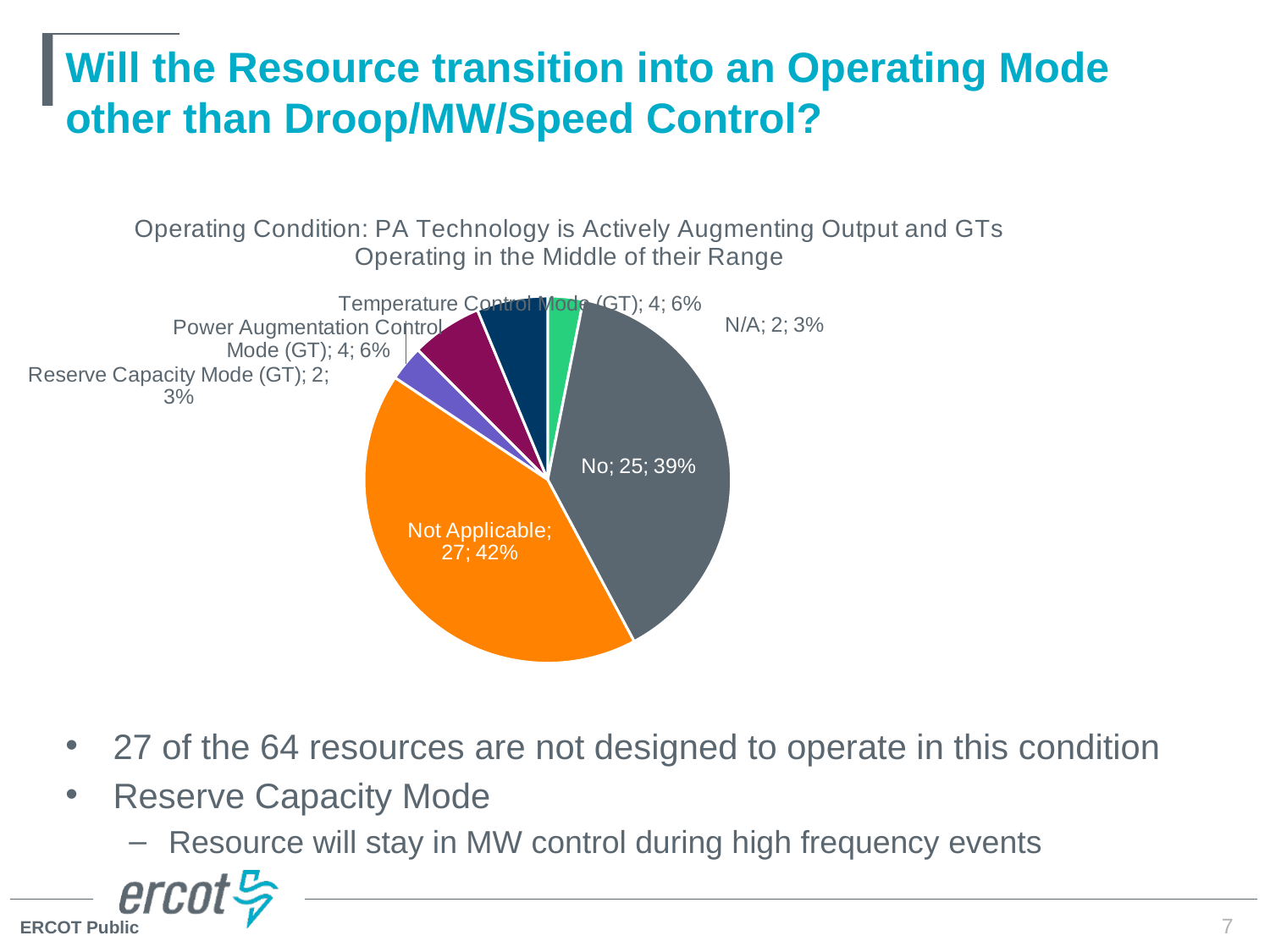
What is the count for "Temperature Control Mode (GT)"? 4 Which slice is the largest? Not Applicable What is the difference in count between "Not Applicable" and "No"? 2 What is the title of the chart? Operating Condition: PA Technology is Actively Augmenting Output and GTs Operating in the Middle of their Range What kind of chart is shown on the slide? pie chart What percentage share does the "No" slice represent? 39% How many slices does the pie chart have? 6 What is the total count across all slices of the pie chart? 64 What colour is the "Not Applicable" slice? orange What percentage share does "Reserve Capacity Mode (GT)" represent? 3% Which is larger, the count for "Power Augmentation Control Mode (GT)" or the count for "N/A"? Power Augmentation Control Mode (GT) How many resources are in the "Not Applicable" slice? 27